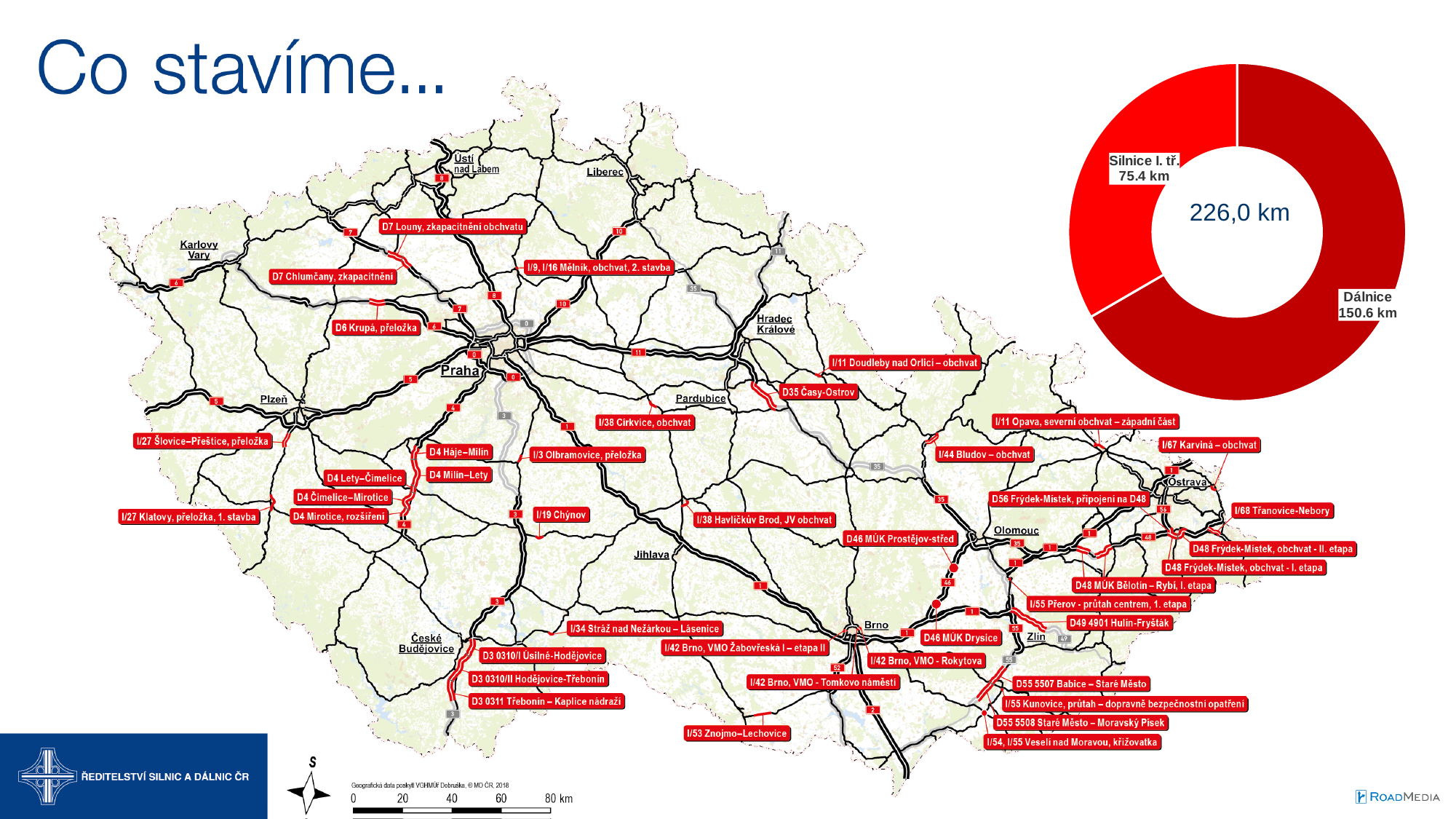
Which category has the smaller slice in the donut chart? Silnice I. tř. What is the value shown for Dálnice in the donut chart? 150.6 km What total is shown in the centre of the donut chart? 226,0 km What is the difference between the Dálnice value and the Silnice I. tř. value in the donut chart? 75.2 km Which category has the larger slice in the donut chart? Dálnice What is the value shown for Silnice I. tř. in the donut chart? 75.4 km How many categories does the donut chart show? 2 What kind of chart is shown on the slide? Donut (pie) chart Is the value for Dálnice larger or smaller than the value for Silnice I. tř.? Larger What is the title of the slide containing the donut chart? Co stavíme... Is the value for Silnice I. tř. greater or less than 100 km? less What colour is the Dálnice slice of the donut chart? Dark red